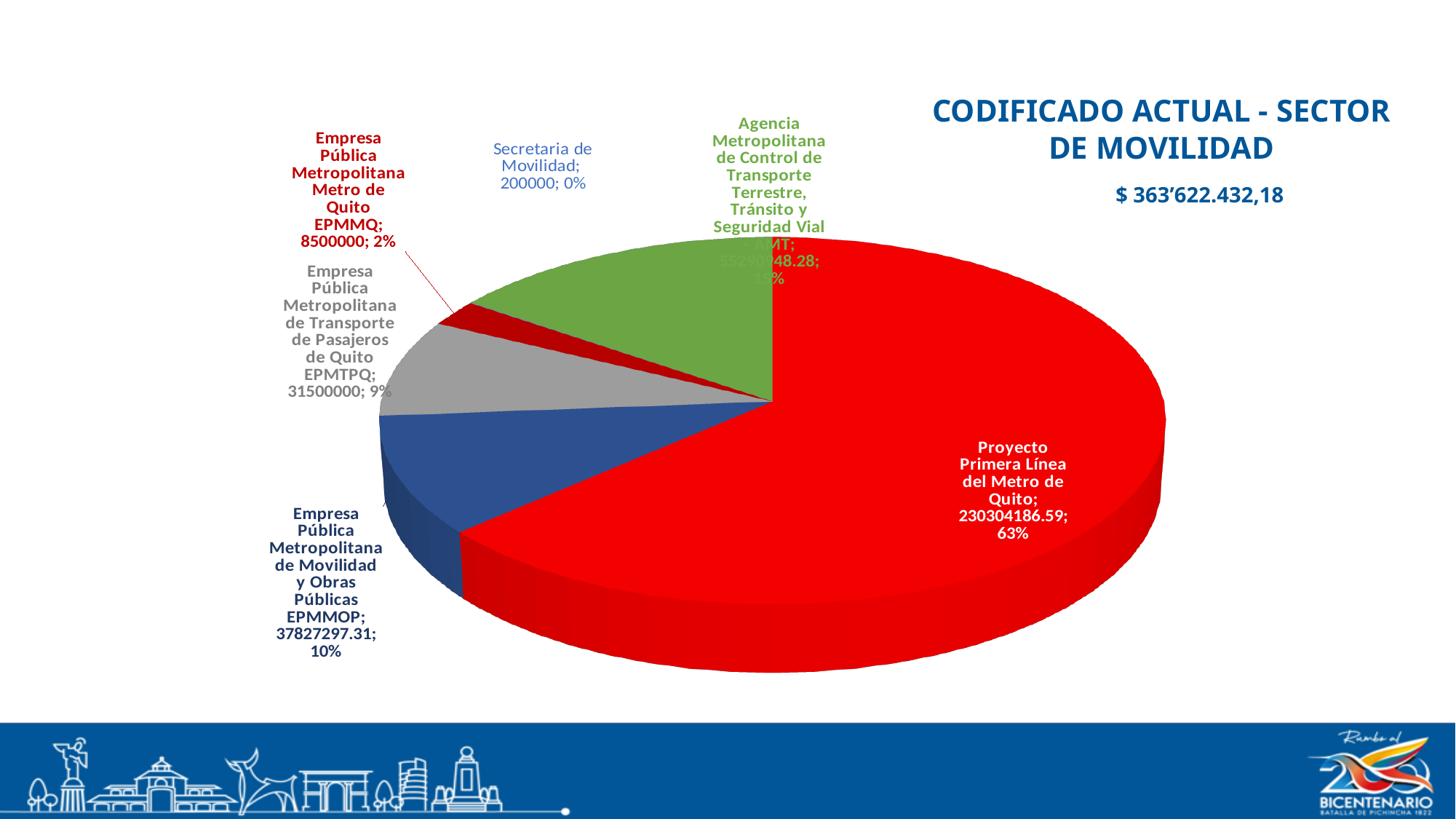
Which category has the largest slice of the pie? Proyecto Primera Línea del Metro de Quito What share of the pie does Proyecto Primera Línea del Metro de Quito represent? 63% What share of the pie does Empresa Pública Metropolitana de Transporte de Pasajeros de Quito EPMTPQ represent? 9% What is the difference between the values for EPMMOP and EPMTPQ? 6327297.31 What is the title of the chart? CODIFICADO ACTUAL - SECTOR DE MOVILIDAD What kind of chart is shown on the slide? pie chart Which is larger, the value for EPMMOP or the value for EPMTPQ? EPMMOP What is the value shown for Empresa Pública Metropolitana de Movilidad y Obras Públicas EPMMOP? 37827297.31 What is the value shown for Proyecto Primera Línea del Metro de Quito? 230304186.59 How many slices does the pie chart have? 6 What is the value shown for Empresa Pública Metropolitana Metro de Quito EPMMQ? 8500000 Which category has the smallest slice of the pie? Secretaria de Movilidad